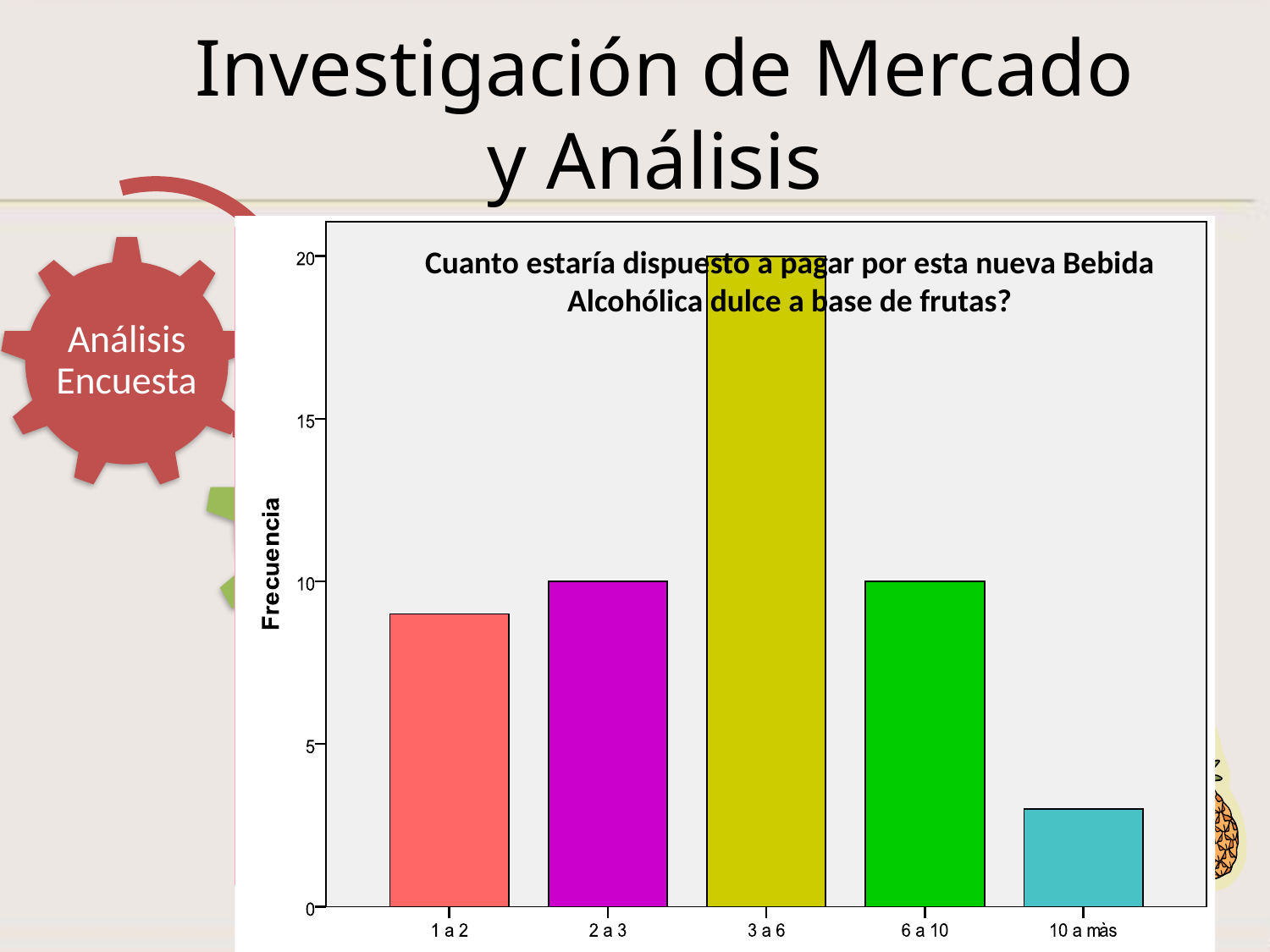
What is the difference between the frequency for 3 a 6 and the frequency for 2 a 3? 10 What is the label of the vertical axis of the chart? Frecuencia Which is larger, the frequency for 3 a 6 or the frequency for 6 a 10? 3 a 6 What type of chart is shown on the slide? bar chart What is the frequency for the category 6 a 10? 10 Is the value for 1 a 2 greater or less than 10? less What is the frequency for the category 3 a 6? 20 Which category has the highest frequency? 3 a 6 Is the value for 10 a màs greater or less than 5? less What is the frequency for the category 2 a 3? 10 How many categories are shown on the x axis of the chart? 5 Which category has the lowest frequency? 10 a màs